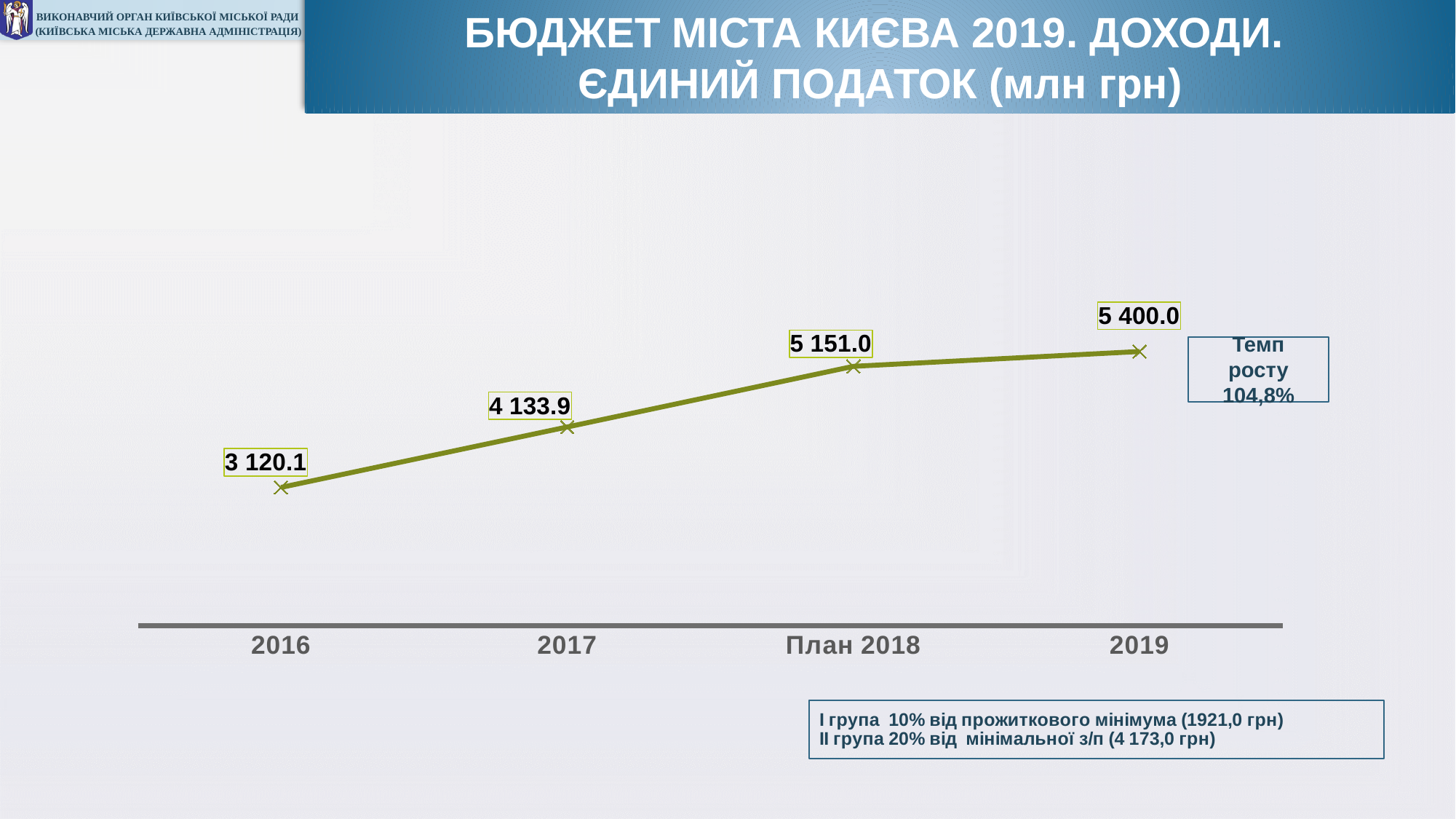
Which year has the lowest value? 2016 What is the difference between the values for 2017 and 2016? 1 013.8 What is the difference between the values for 2019 and План 2018? 249.0 How many data points are plotted on the chart? 4 What is the value for 2017? 4 133.9 Which year has the highest value? 2019 Which is larger, the value for 2017 or the value for План 2018? План 2018 What is the value for План 2018? 5 151.0 What kind of chart is shown on the slide? line chart What is the value for 2019? 5 400.0 Do the values rise or fall from 2016 to 2019? rise What is the value for 2016? 3 120.1